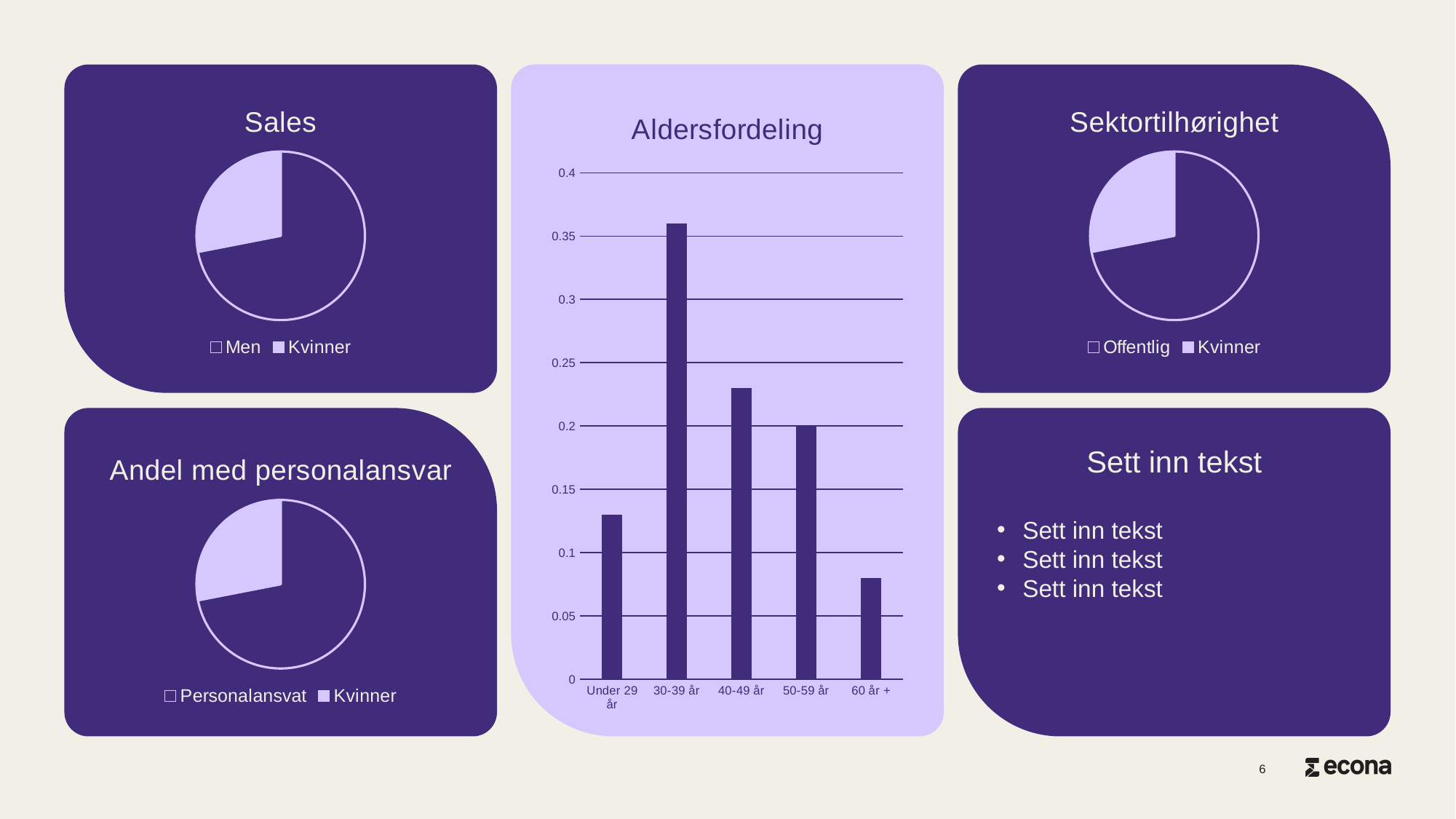
In the Aldersfordeling chart, which age category has the highest value? 30-39 år In the Aldersfordeling chart, which is larger: the value for 40-49 år or the value for Under 29 år? 40-49 år What kind of chart is the Aldersfordeling chart? bar chart What are the legend entries of the Sektortilhørighet chart? Offentlig, Kvinner In the Aldersfordeling chart, is the value for 30-39 år greater or less than 0.3? greater In the Aldersfordeling chart, is the value for Under 29 år greater or less than 0.15? less How many age categories are shown on the x axis of the Aldersfordeling chart? 5 In the Sales pie chart, which slice is larger: Men or Kvinner? Men How many entries does the legend of the Sales chart list? 2 What kind of chart is the Sales chart? pie chart In the Aldersfordeling chart, which age category has the lowest value? 60 år + In the Aldersfordeling chart, is the value for 60 år + greater or less than 0.1? less